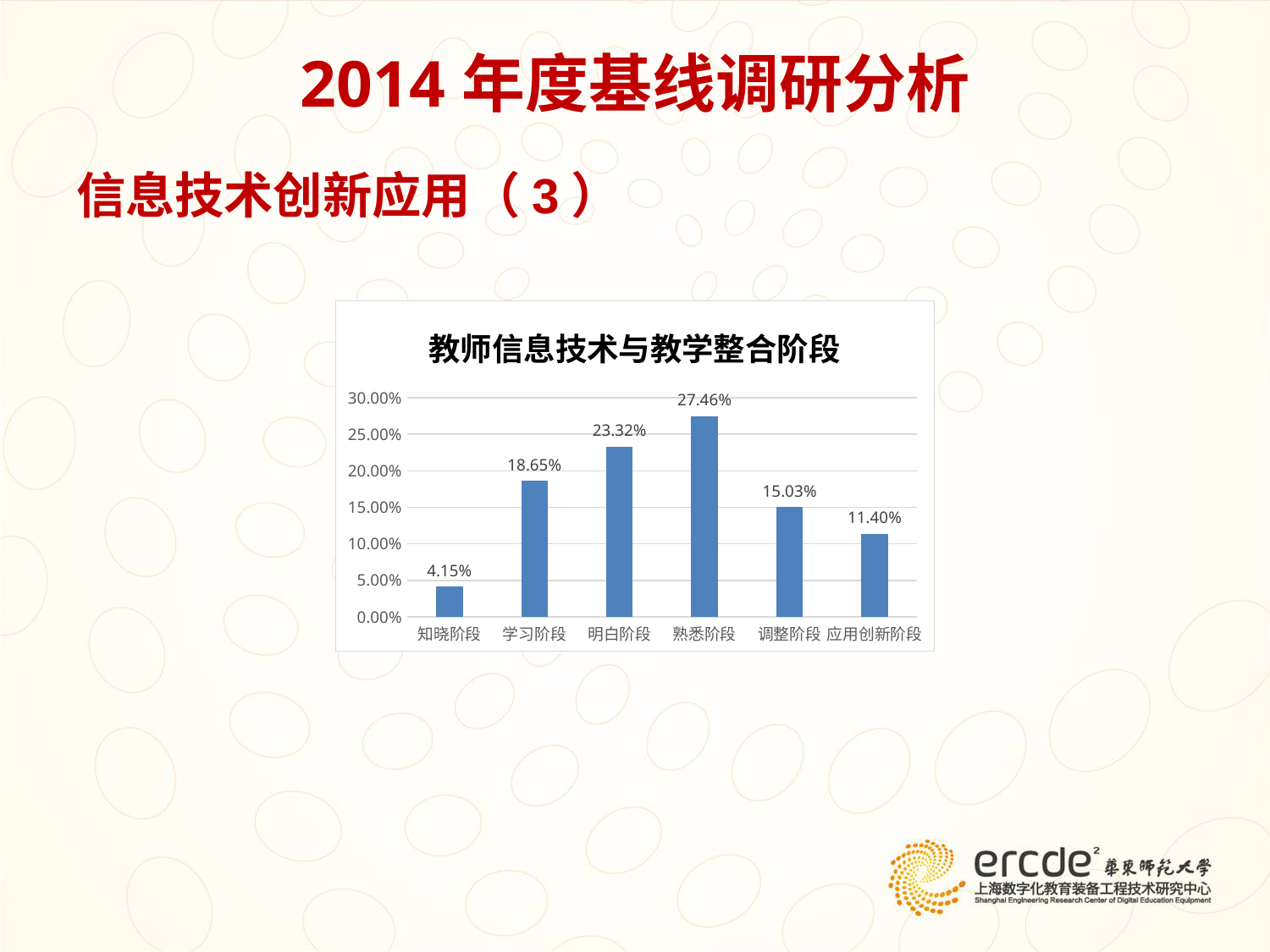
How many categories are shown on the x axis? 6 What is the title of the chart? 教师信息技术与教学整合阶段 What kind of chart is this? bar chart What is the value for 知晓阶段? 4.15% Is the value for 明白阶段 greater or less than 20.00%? greater What is the difference between the values for 学习阶段 and 调整阶段? 3.62% Which is larger, the value for 调整阶段 or the value for 应用创新阶段? 调整阶段 What is the difference between the values for 熟悉阶段 and 明白阶段? 4.14% What is the value for 应用创新阶段? 11.40% Which category has the lowest value? 知晓阶段 What is the value for 熟悉阶段? 27.46% Which category has the highest value? 熟悉阶段